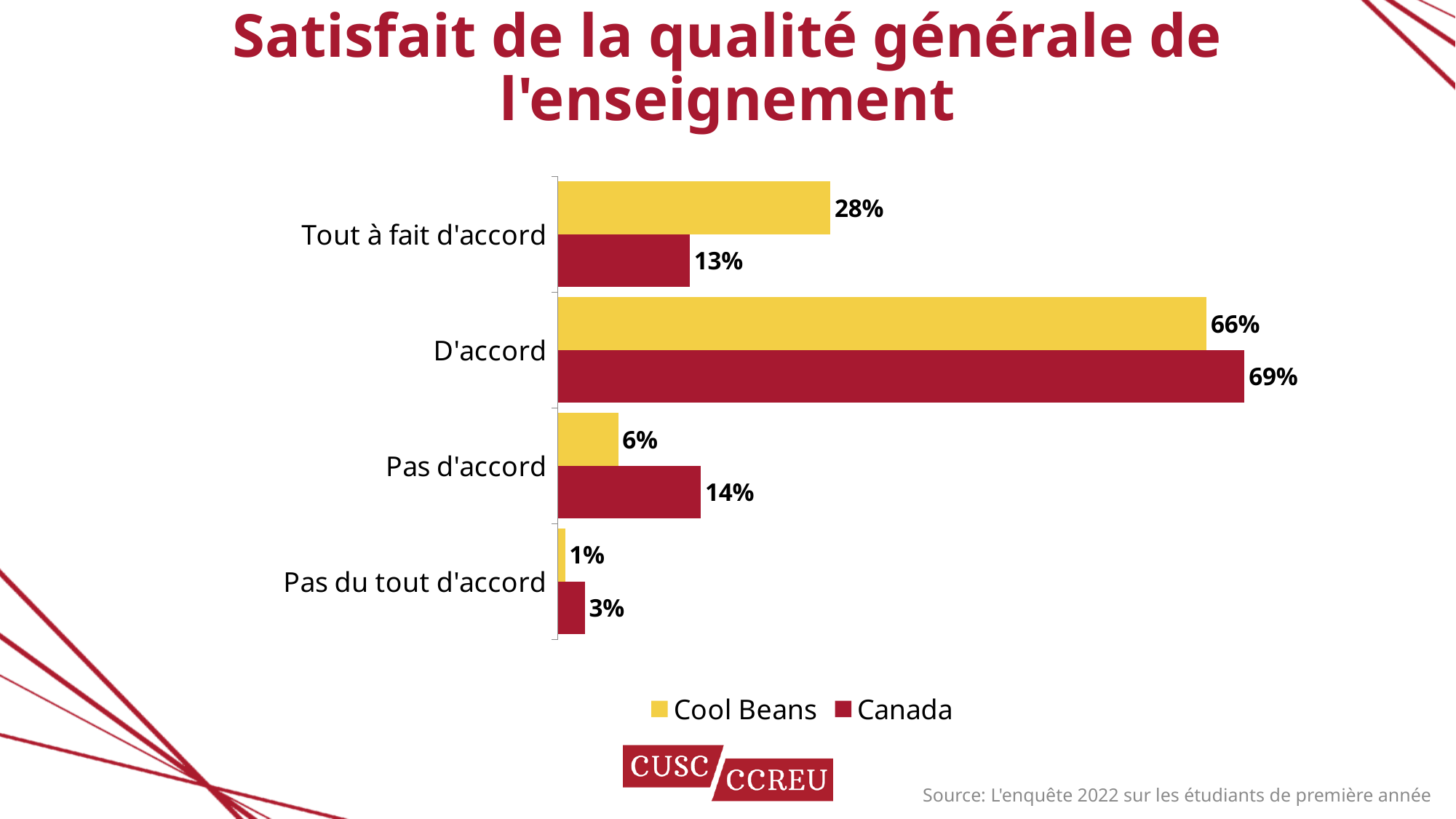
What is the Cool Beans value for "Tout à fait d'accord"? 28% Which category has the highest Cool Beans value? D'accord What is the difference between the Cool Beans and Canada values for "Tout à fait d'accord"? 15% How many categories are shown on the chart? 4 For "Pas du tout d'accord", which series has the larger value, Cool Beans or Canada? Canada Which category has the lowest Canada value? Pas du tout d'accord How many series does the legend list? 2 For "Tout à fait d'accord", which series has the larger value, Cool Beans or Canada? Cool Beans What is the difference between the Canada and Cool Beans values for "Pas d'accord"? 8% What is the Canada value for "D'accord"? 69% What is the Canada value for "Pas d'accord"? 14% What kind of chart is shown on the slide? Bar chart